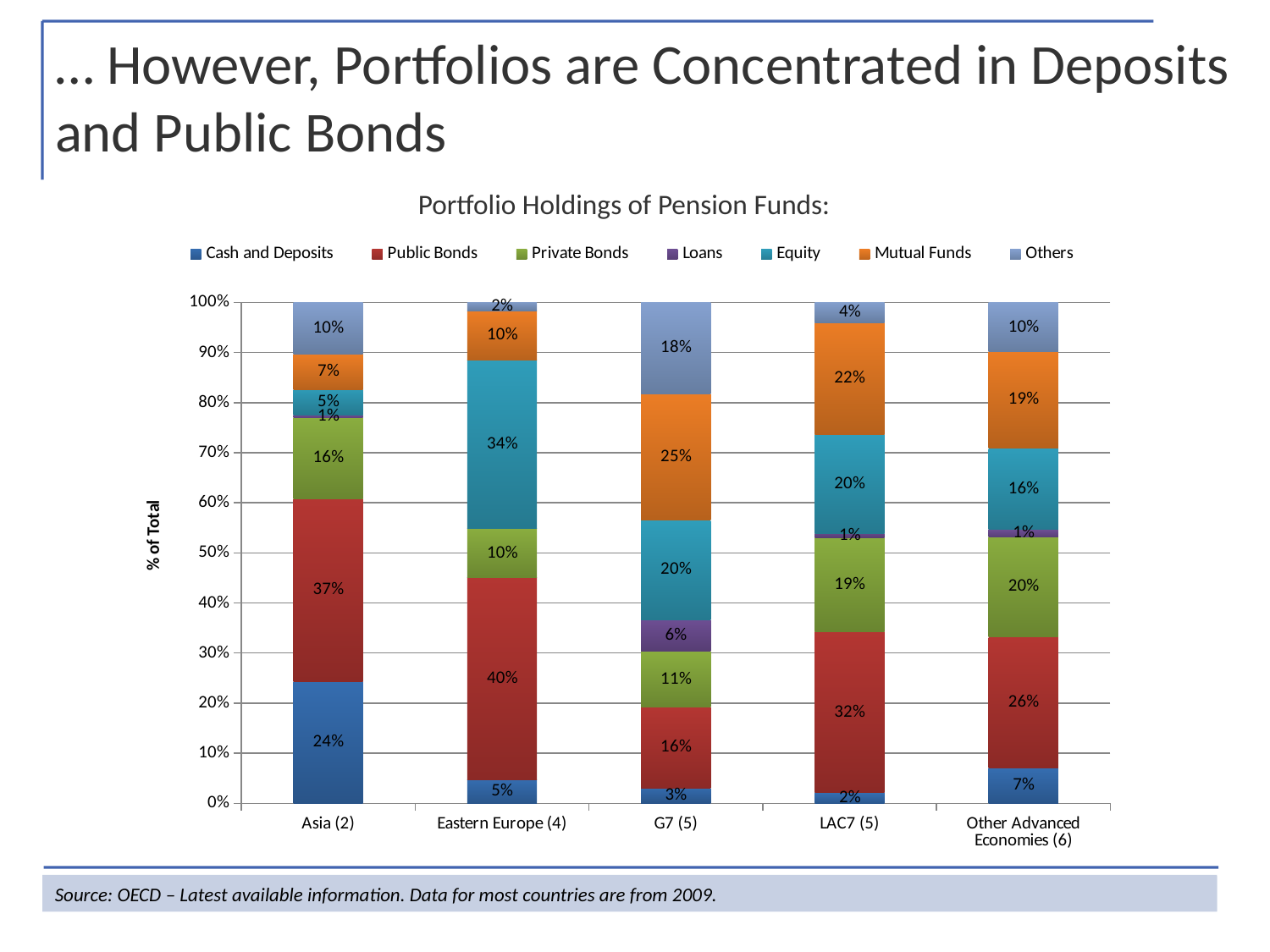
What is the difference between the Public Bonds share for Eastern Europe (4) and for G7 (5)? 24 percentage points How many series does the legend list? 7 Which region has the lowest Cash and Deposits share? LAC7 (5) What is the title of the chart? Portfolio Holdings of Pension Funds: What is the Public Bonds share for LAC7 (5)? 32% Which is larger: the Others share for G7 (5) or for Other Advanced Economies (6)? G7 (5) What is the Mutual Funds share for G7 (5)? 25% Which region has the highest Cash and Deposits share? Asia (2) What type of chart is shown on the slide? Stacked bar chart What is the Cash and Deposits share for Asia (2)? 24% How many regional categories are shown on the x axis? 5 What is the Equity share for Eastern Europe (4)? 34%